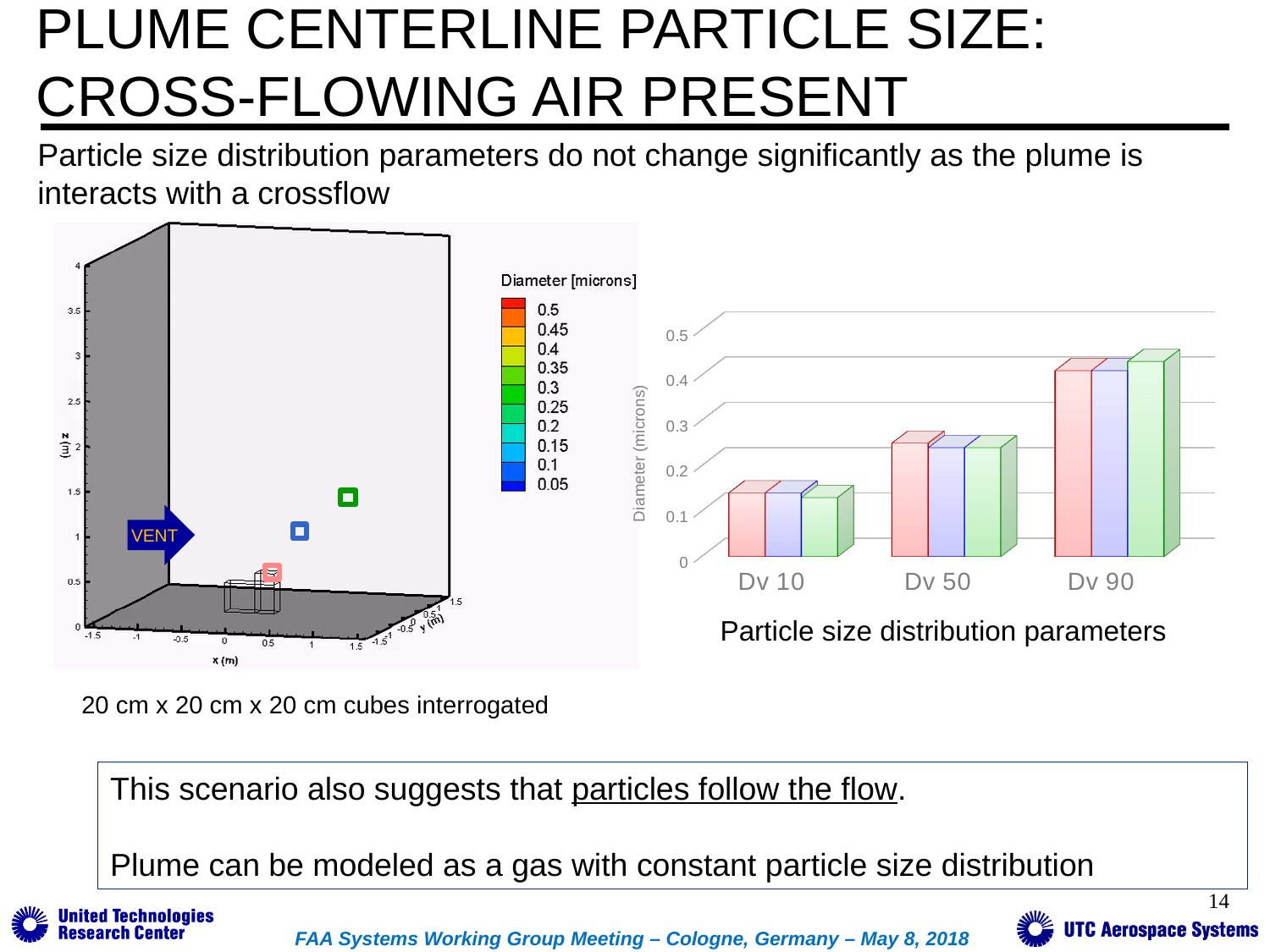
How many categories are shown on the x axis of the bar chart on the right? 3 In the bar chart on the right, which category has the shortest bars? Dv 10 In the bar chart on the right, are the values for Dv 90 greater or less than 0.3? greater In the bar chart on the right, do the values rise or fall from Dv 10 to Dv 90? rise In the bar chart on the right, are the values for Dv 10 greater or less than 0.2? less In the bar chart on the right, are the values for Dv 50 greater or less than 0.2? greater What kind of chart is shown on the right side of the slide? bar chart In the bar chart on the right, which category has the tallest bars? Dv 90 In the bar chart on the right, which category has larger values, Dv 10 or Dv 90? Dv 90 How many bars are plotted for each category in the bar chart on the right? 3 What is the y-axis title of the bar chart on the right? Diameter (microns)